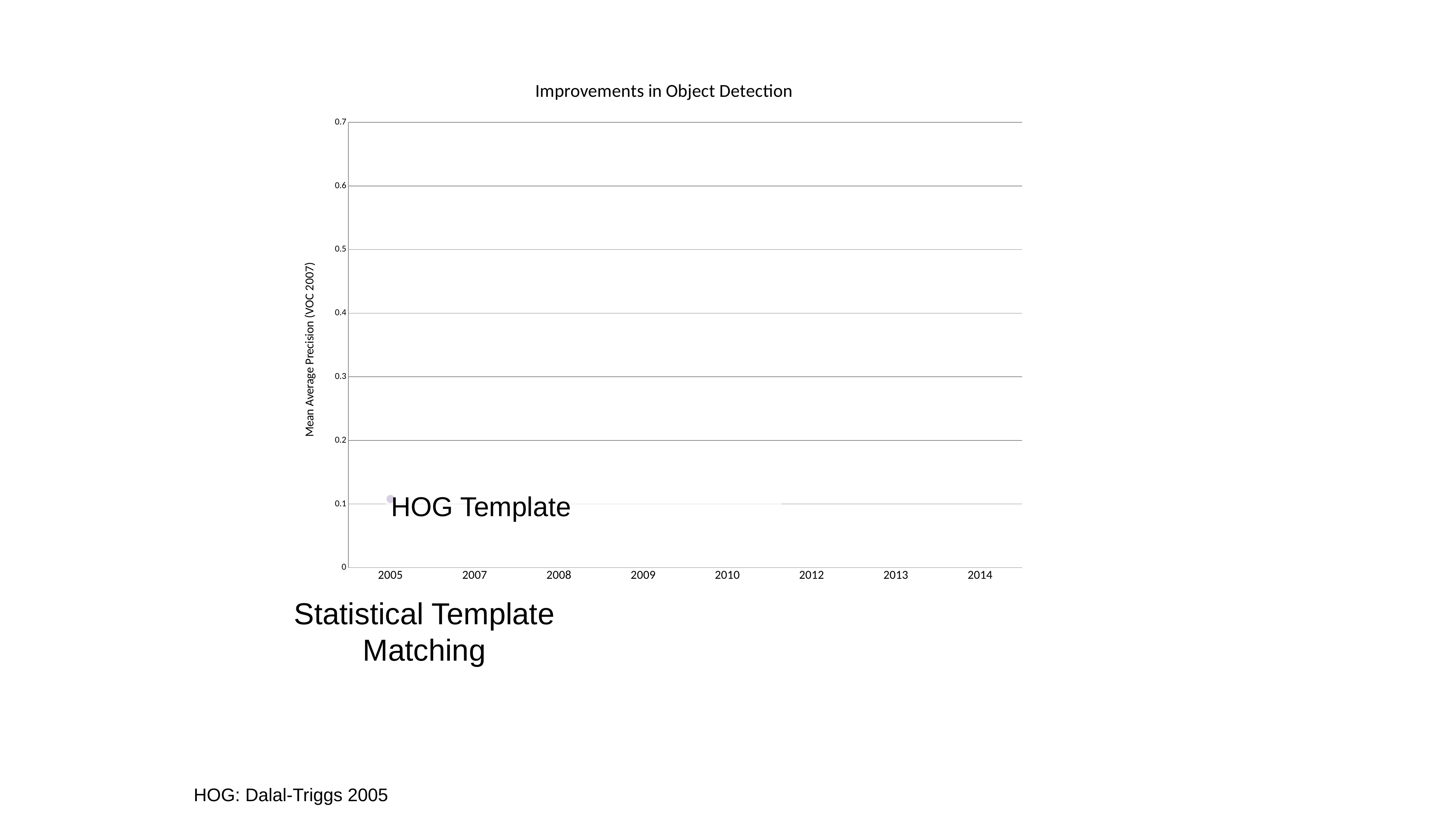
What is the highest value shown on the vertical axis of the chart? 0.7 Is the value for the HOG Template point in 2005 greater or less than 0.2? less What text label is attached to the plotted point in the chart? HOG Template What is the label of the vertical axis of the chart? Mean Average Precision (VOC 2007) Which year is the data point labelled "HOG Template" plotted at? 2005 Is the value for the HOG Template point in 2005 greater or less than 0.3? less How many year labels are shown along the x axis of the chart? 8 What is the last year shown on the x axis of the chart? 2014 What is the title of the chart? Improvements in Object Detection What is the first year shown on the x axis of the chart? 2005